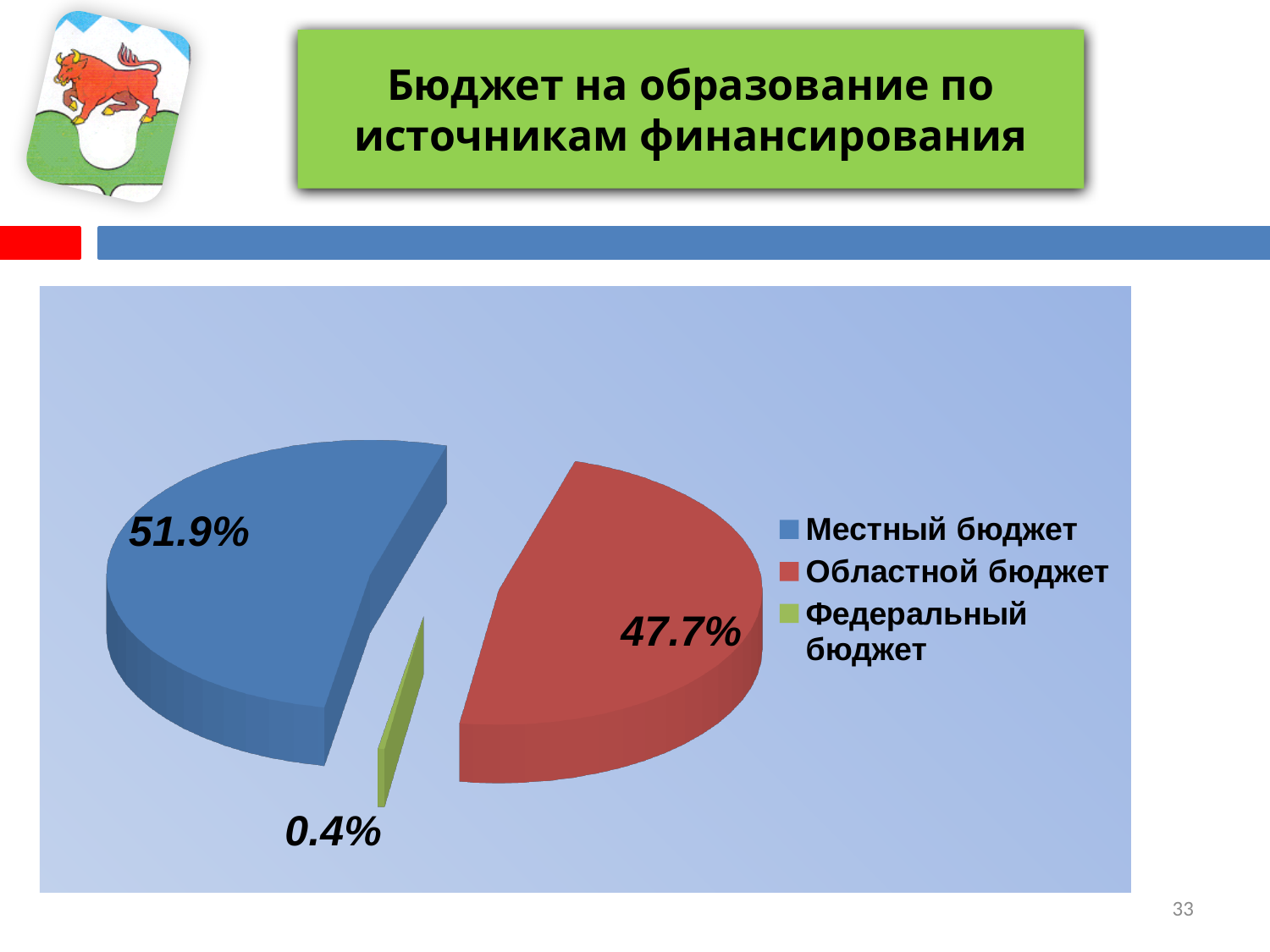
What is the combined share of Местный бюджет and Областной бюджет? 99.6% What type of chart is shown on the slide? Pie chart What share of the education budget comes from Местный бюджет? 51.9% Which funding source has the largest share of the education budget? Местный бюджет What is the title of the chart on the slide? Бюджет на образование по источникам финансирования What share of the education budget comes from Областной бюджет? 47.7% How many funding sources are shown in the pie chart? 3 What share of the education budget comes from Федеральный бюджет? 0.4% What is the difference in percentage points between the Местный бюджет and Областной бюджет shares? 4.2 Which is larger: the share of Областной бюджет or the share of Федеральный бюджет? Областной бюджет Which funding source has the smallest share of the education budget? Федеральный бюджет What colour represents Областной бюджет in the pie chart? Red